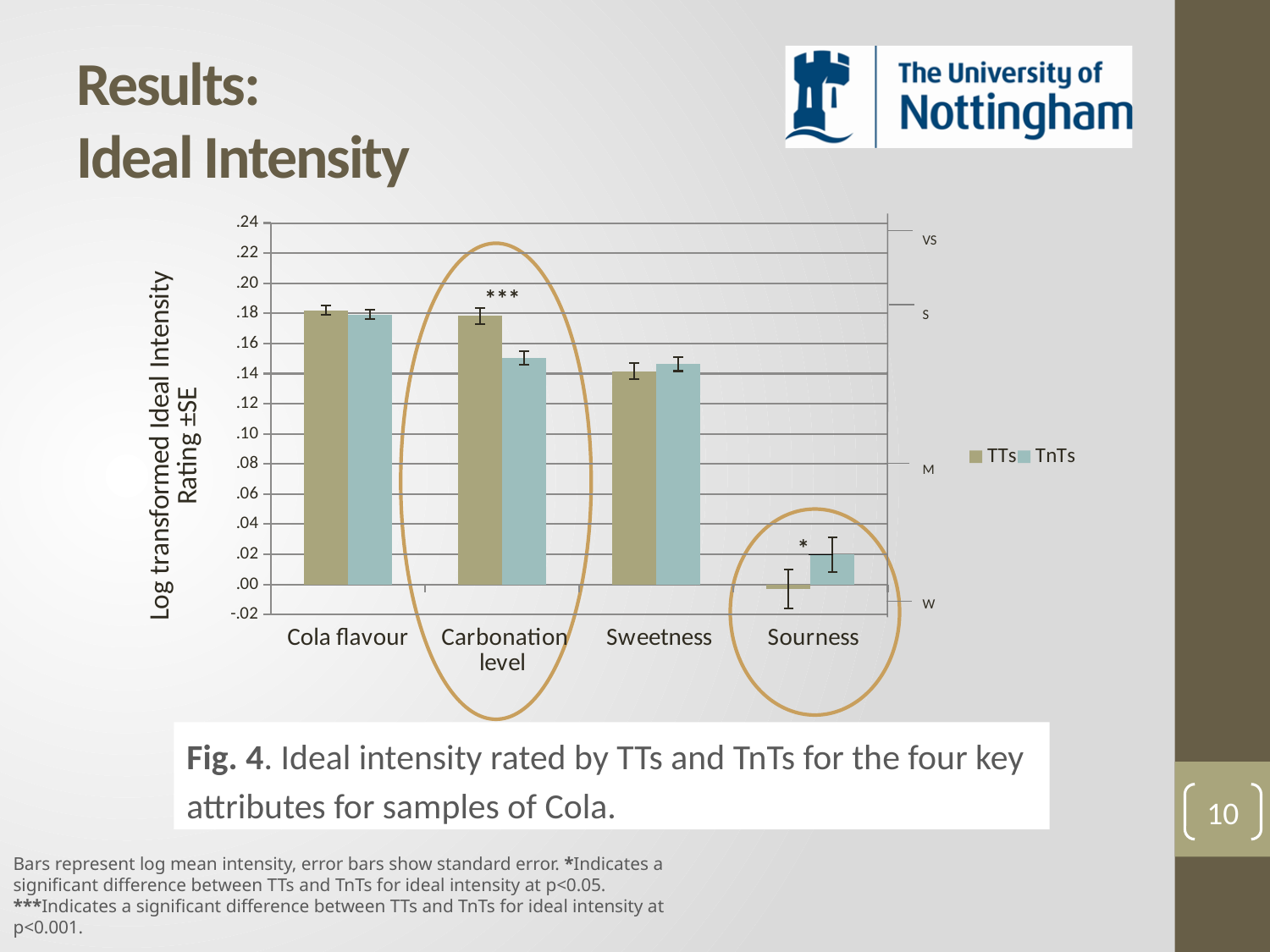
Is the TnTs value for Sourness greater or less than .04? less For Sourness, which series has the larger value, TTs or TnTs? TnTs Which category has the highest value for the TnTs series? Cola flavour What is the y-axis title of the chart? Log transformed Ideal Intensity Rating ±SE How many series does the chart legend list? 2 What kind of chart is shown on the slide? bar chart What are the two series named in the chart legend? TTs and TnTs Is the TnTs value for Carbonation level greater or less than .16? less For Carbonation level, which series has the larger value, TTs or TnTs? TTs Is the TTs value for Sweetness greater or less than .12? greater How many attribute categories are shown on the x axis of the chart? 4 Which category has the lowest value for the TTs series? Sourness